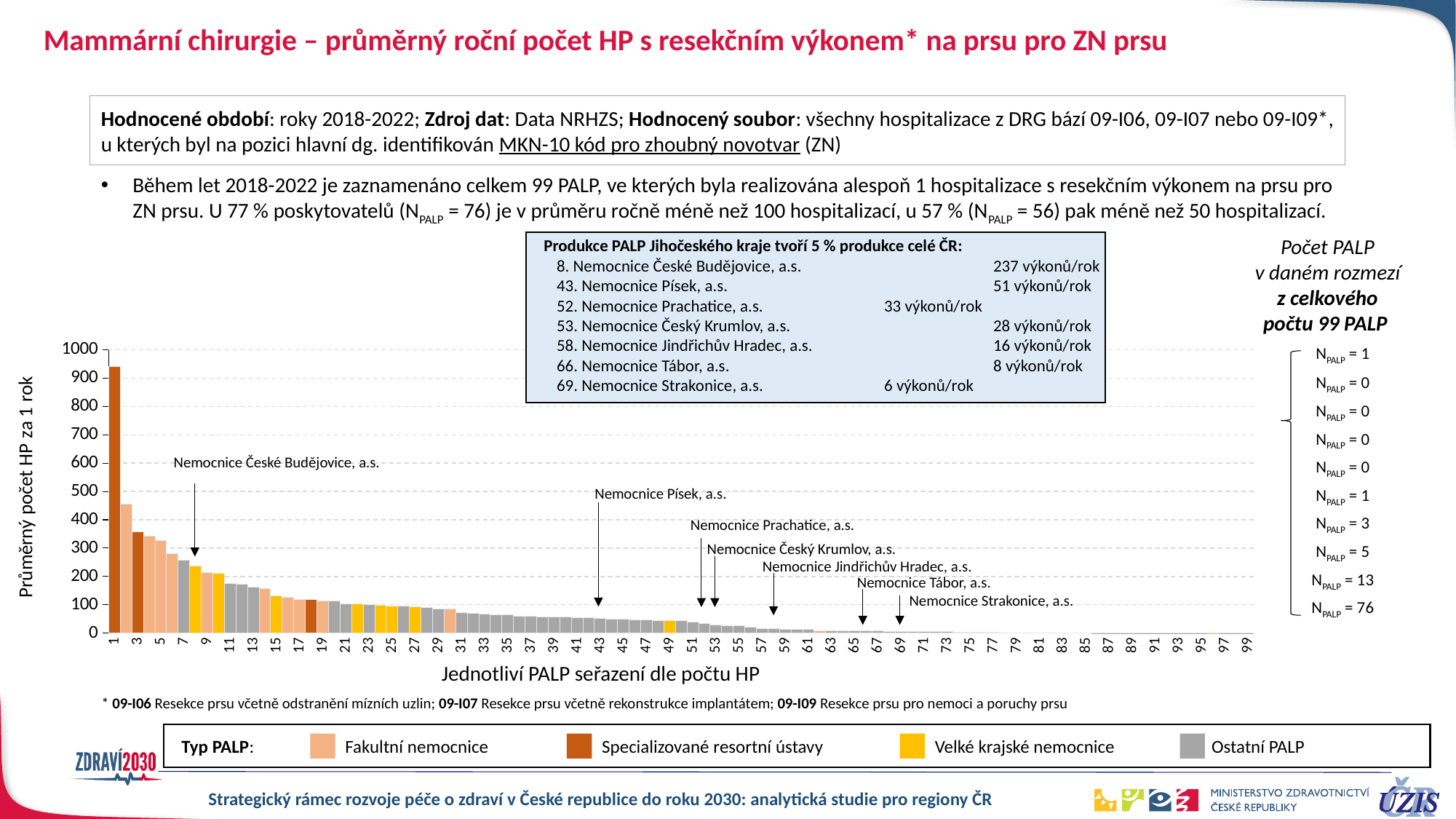
Do the bar values rise or fall from left to right along the x axis? fall What is the difference between the annual procedure counts of Nemocnice České Budějovice, a.s. and Nemocnice Písek, a.s.? 186 What colour in the legend represents 'Velké krajské nemocnice'? yellow How many PALP types does the legend 'Typ PALP' list? 4 According to the text box, what is the average annual number of procedures for Nemocnice Písek, a.s.? 51 výkonů/rok Is the value of the second bar (PALP 2) greater or less than 400? greater Which has more procedures per year, Nemocnice Prachatice, a.s. or Nemocnice Český Krumlov, a.s.? Nemocnice Prachatice, a.s. According to the text box, what is the average annual number of procedures for Nemocnice Strakonice, a.s.? 6 výkonů/rok Is the value of the first (tallest) bar greater or less than 900? greater What kind of chart is shown on the slide? bar chart According to the text box, what is the average annual number of procedures for Nemocnice České Budějovice, a.s.? 237 výkonů/rok How many PALP (providers) are plotted along the x axis of the chart? 99